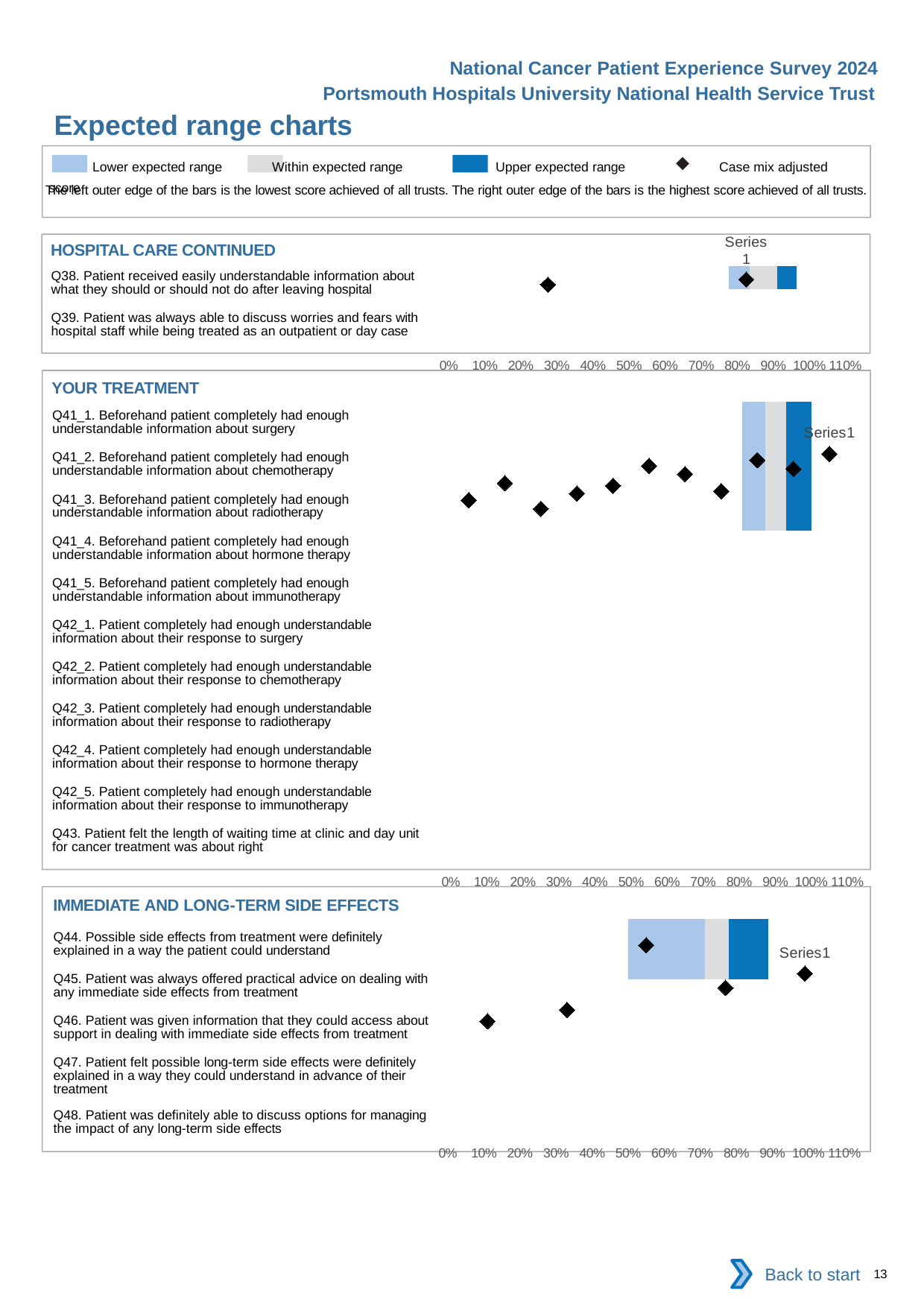
How many questions (categories) are listed in the 'IMMEDIATE AND LONG-TERM SIDE EFFECTS' chart? 5 How many questions (categories) are listed in the 'YOUR TREATMENT' chart? 11 In the 'IMMEDIATE AND LONG-TERM SIDE EFFECTS' chart, is the leftmost diamond marker greater or less than 30%? less What kind of chart is used in the 'YOUR TREATMENT' section? Bar chart According to the legend, what does the diamond marker represent? Case mix adjusted score In the 'YOUR TREATMENT' chart, is the rightmost diamond marker greater or less than 90%? greater How many entries does the legend at the top of the slide list? 4 According to the legend, which colour represents the upper expected range? Dark blue How many questions (categories) are listed in the 'HOSPITAL CARE CONTINUED' chart? 2